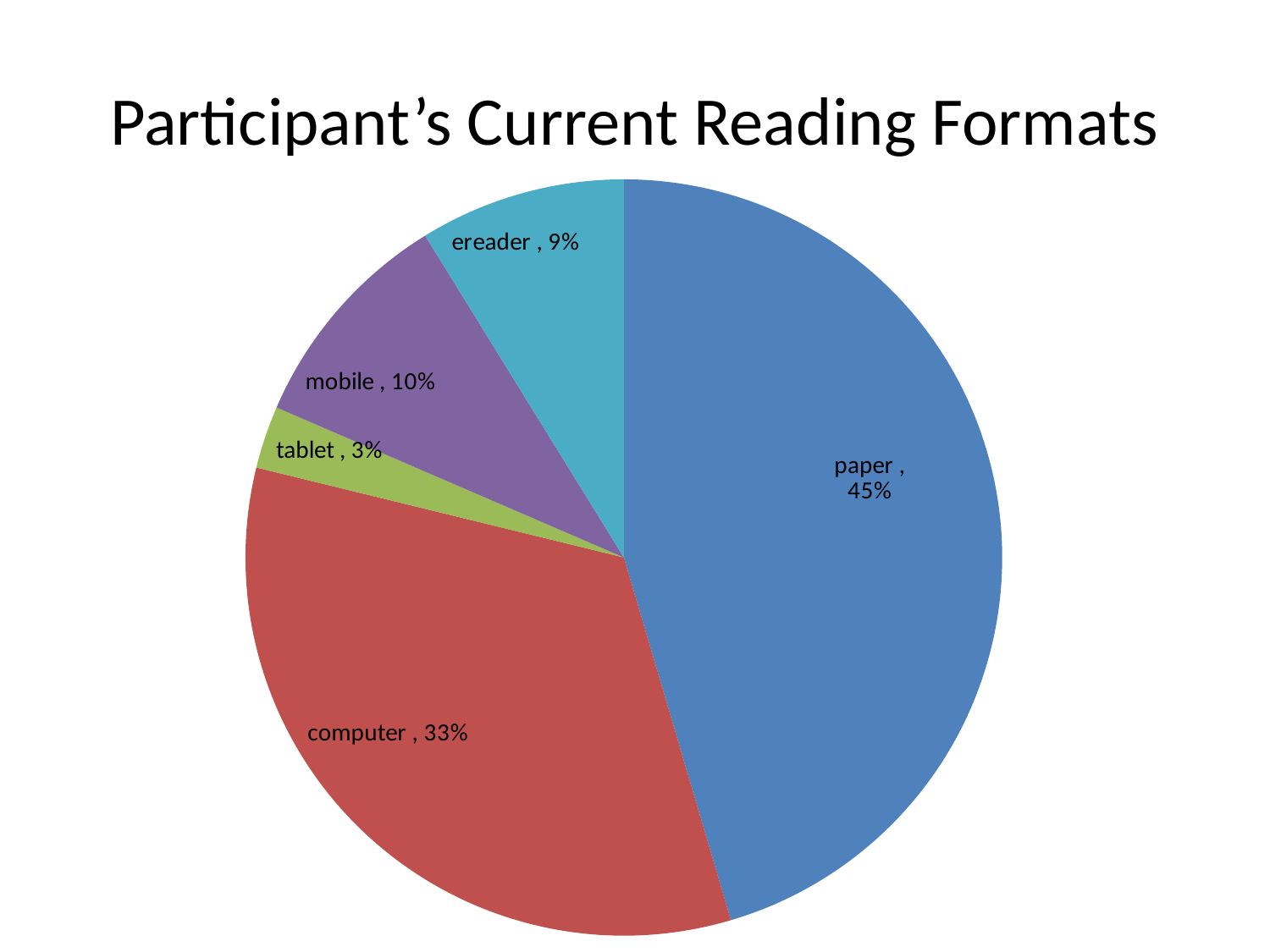
What is the value shown for ereader? 9% What is the value shown for tablet? 3% What share of the pie does paper account for? 45% Which is larger, the share for mobile or the share for ereader? mobile What type of chart is shown on the slide? pie chart What is the difference in percentage points between paper and computer? 12 Which reading format has the largest slice? paper How many slices does the pie chart have? 5 What is the value shown for mobile? 10% What share of the pie does computer account for? 33% Which reading format has the smallest slice? tablet What is the title of the chart? Participant's Current Reading Formats